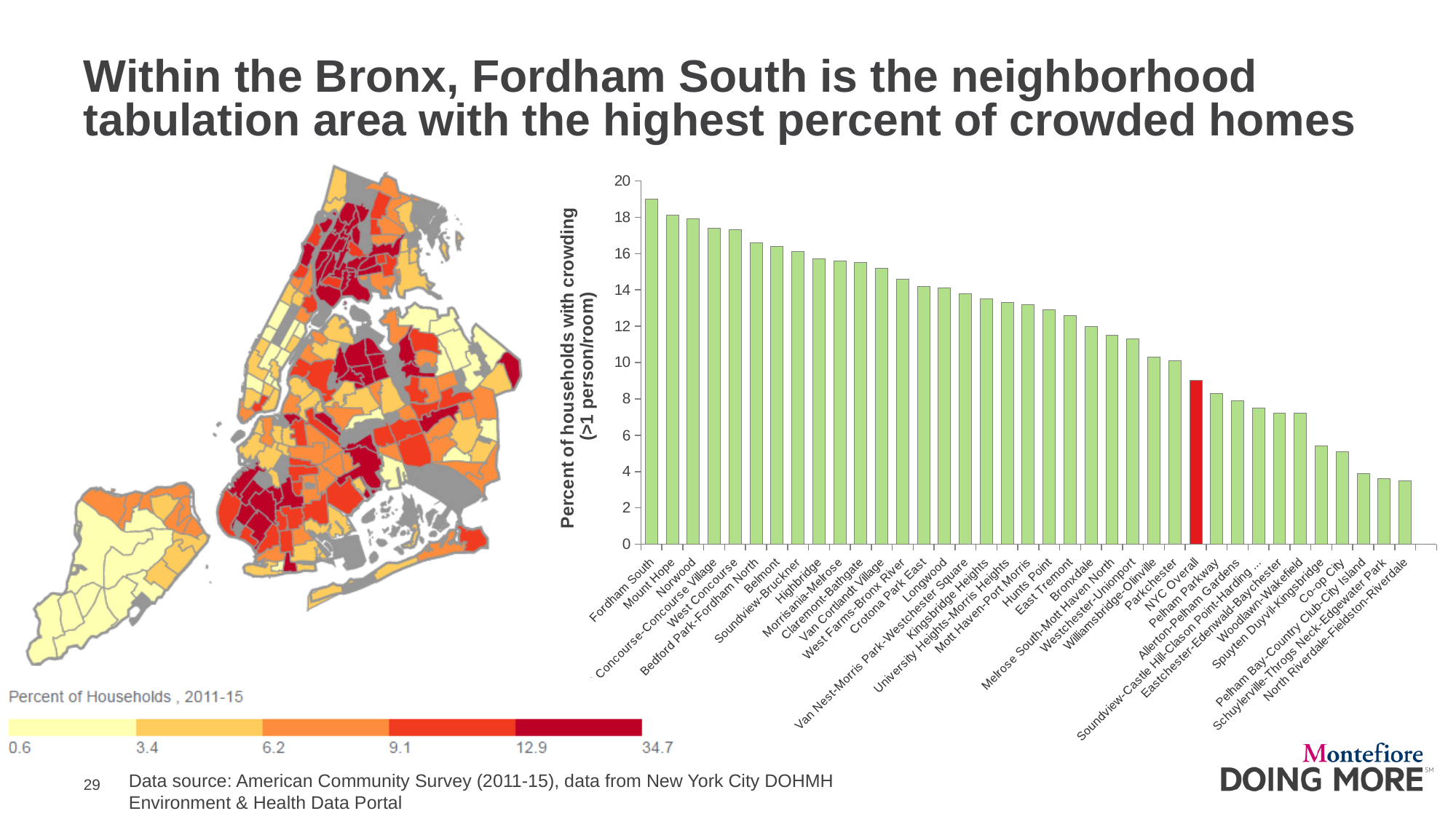
Which neighborhood tabulation area has the lowest percent of households with crowding in the bar chart? North Riverdale-Fieldston-Riverdale In the bar chart, which has a higher percent of households with crowding, Mount Hope or Pelham Parkway? Mount Hope In the bar chart, is the value for Co-op City greater or less than 4? greater In the bar chart, which has a lower percent of households with crowding, Belmont or Woodlawn-Wakefield? Woodlawn-Wakefield Which bar in the bar chart is colored red instead of green? NYC Overall In the bar chart, is the value for North Riverdale-Fieldston-Riverdale greater or less than 4? less Which neighborhood tabulation area has the highest percent of households with crowding in the bar chart? Fordham South Do the values in the bar chart rise or fall from left to right along the x axis? fall In the bar chart, is the value for NYC Overall greater or less than 10? less What kind of chart is shown on the right side of the slide? bar chart